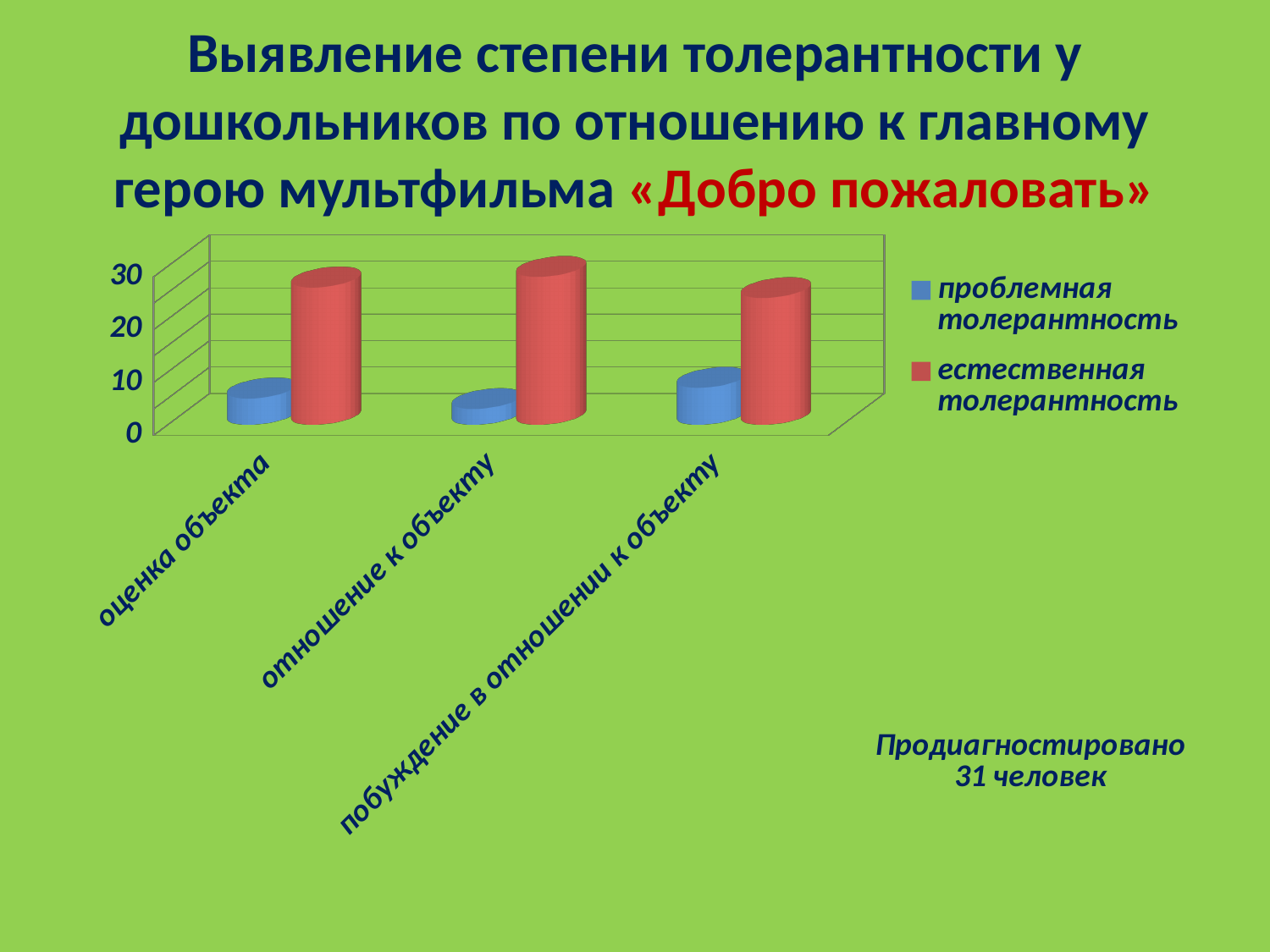
Which category has the highest value for the series "проблемная толерантность"? побуждение в отношении к объекту Which category has the highest value for the series "естественная толерантность"? отношение к объекту Which colour represents the series "естественная толерантность" in the chart? red Is the value of "проблемная толерантность" for "отношение к объекту" greater or less than 10? less Is the value of "естественная толерантность" for "отношение к объекту" greater or less than 20? greater Is the value of "проблемная толерантность" for "оценка объекта" greater or less than 10? less How many categories are shown on the x axis of the chart? 3 How many series does the chart legend list? 2 Which category has the lowest value for the series "проблемная толерантность"? отношение к объекту What kind of chart is shown on the slide? bar chart For the category "оценка объекта", which series has the larger value: "проблемная толерантность" or "естественная толерантность"? естественная толерантность According to the note on the slide, how many people were diagnosed? 31 человек